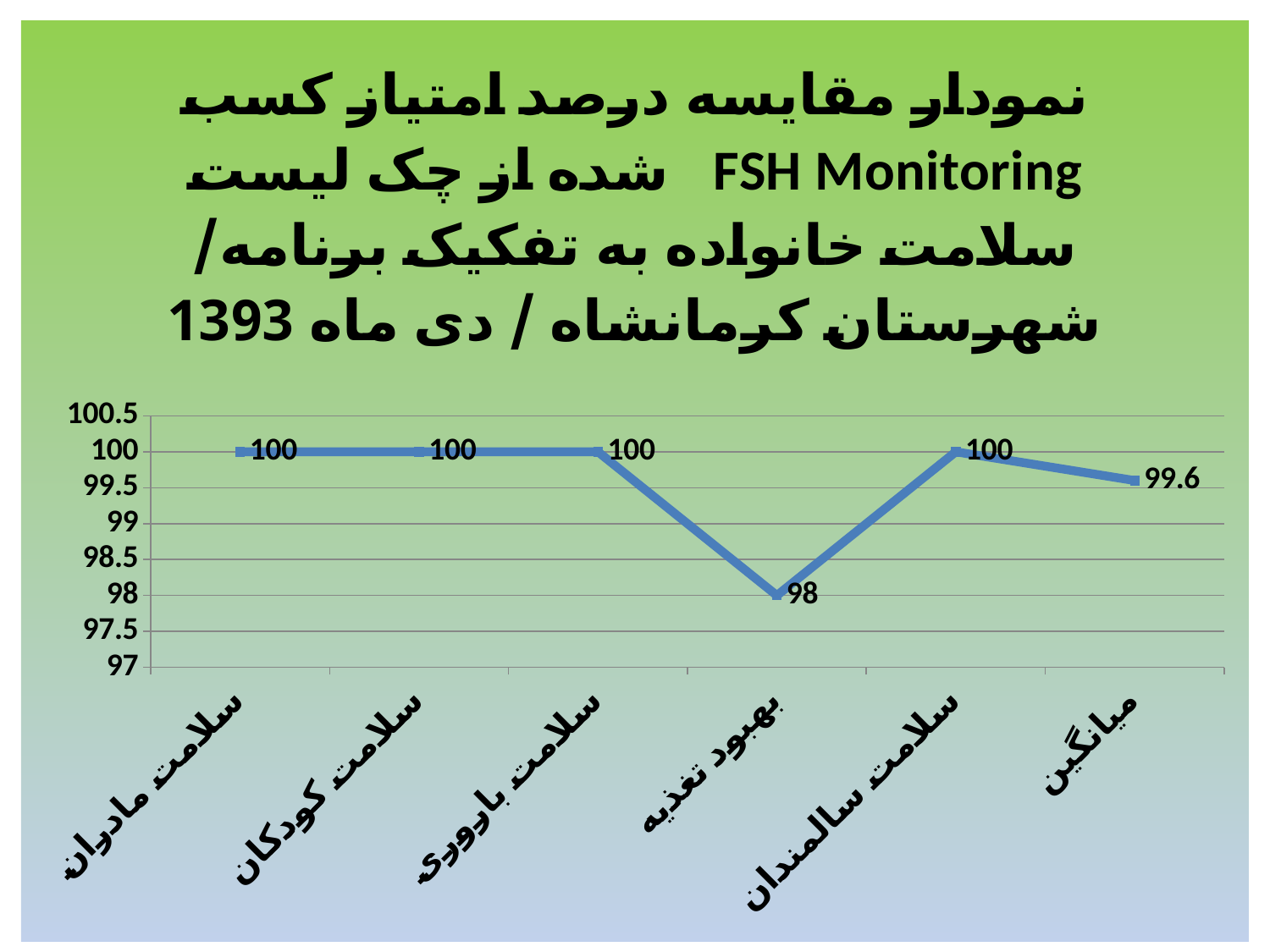
What is the value for میانگین? 99.6 What is the value for بهبود تغذیه? 98 What is the difference between the value for سلامت سالمندان and the value for بهبود تغذیه? 2 What is the value for سلامت مادران? 100 Which category has the lowest value? بهبود تغذیه Is the value for بهبود تغذیه greater or less than 99? less How many categories are shown on the x axis? 6 What kind of chart is shown on the slide? line chart How many categories have a value of 100? 4 What is the difference between the value for میانگین and the value for بهبود تغذیه? 1.6 What is the highest value shown on the y axis? 100.5 Which is larger, the value for سلامت کودکان or the value for میانگین? سلامت کودکان